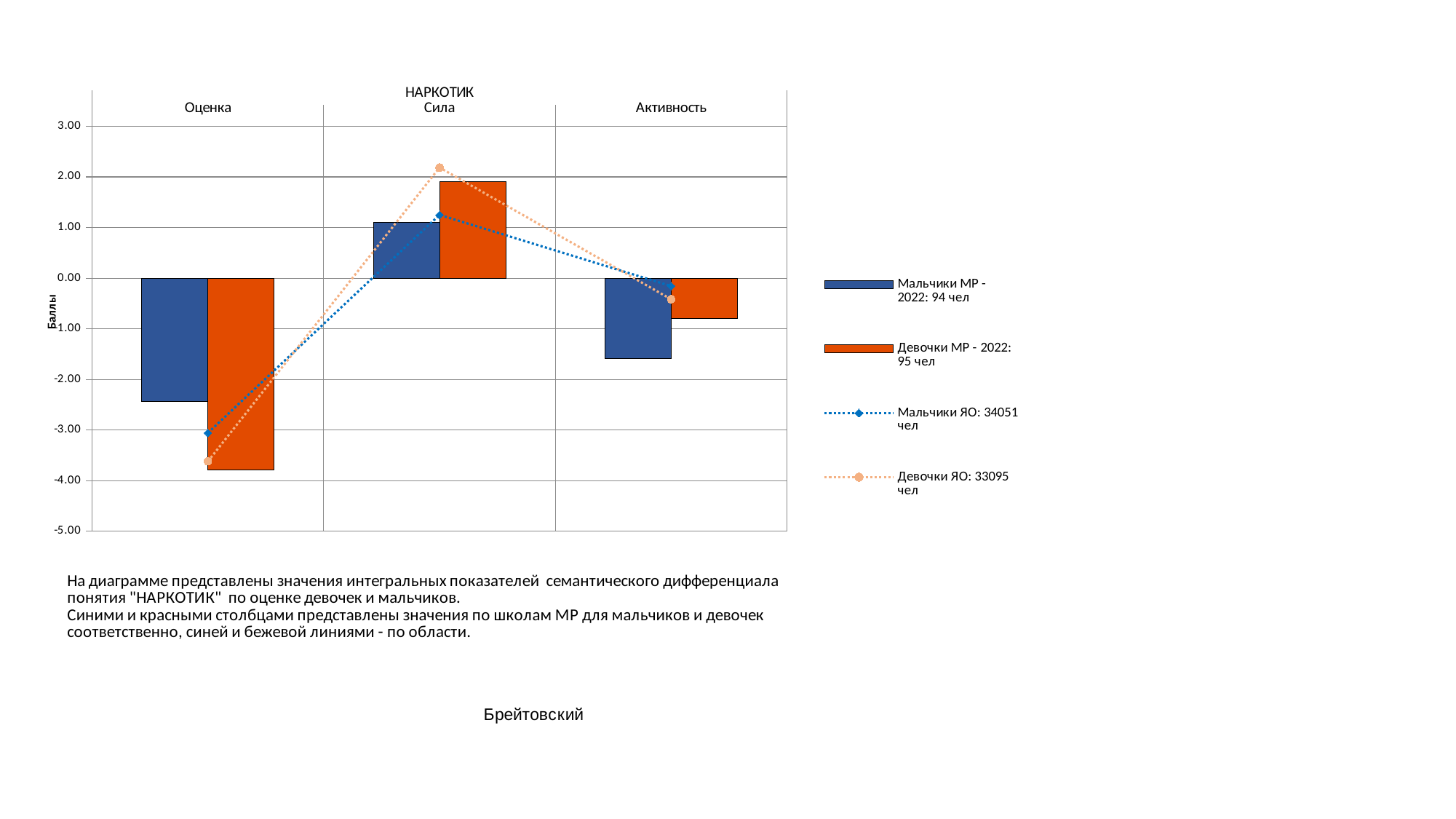
What is the title of the chart? НАРКОТИК For the category Сила, which bar is taller: Мальчики МР - 2022 or Девочки МР - 2022? Девочки МР - 2022 What is the label of the vertical axis? Баллы Is the value of the Мальчики МР - 2022 bar for Оценка greater or less than -3.00? greater How many series does the chart legend list? 4 For which category does the Девочки МР - 2022 series have its lowest value? Оценка Is the value of the Девочки МР - 2022 bar for Сила greater or less than 1.00? greater For which category does the Мальчики МР - 2022 series have its highest value? Сила Is the value of the Девочки МР - 2022 bar for Оценка greater or less than -3.00? less How many categories are shown on the x axis of the chart? 3 For the category Сила, which line is higher: Мальчики ЯО or Девочки ЯО? Девочки ЯО